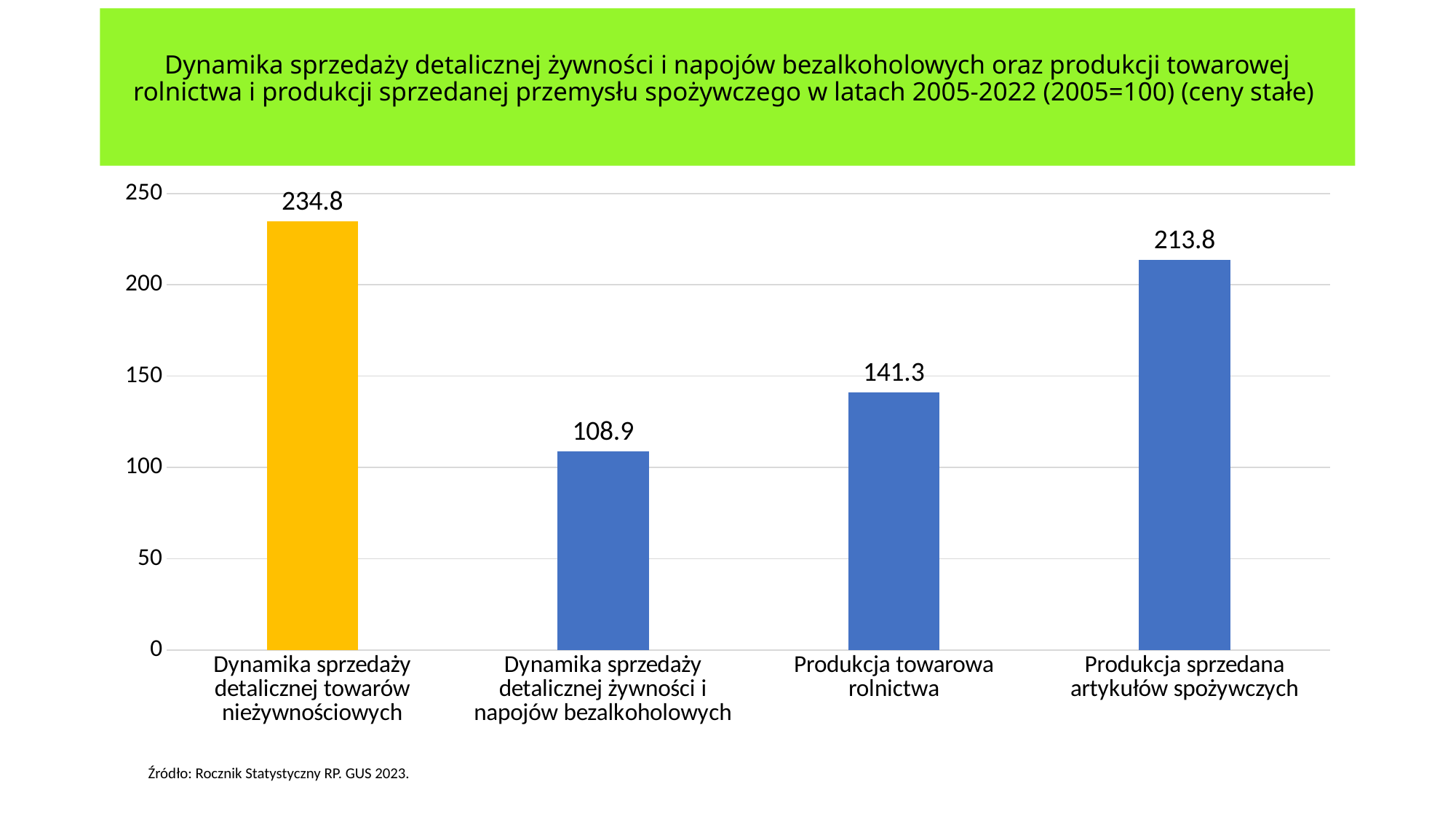
How many categories are shown on the chart? 4 What is the value for "Produkcja sprzedana artykułów spożywczych"? 213.8 Is the value for "Produkcja towarowa rolnictwa" greater or less than 150? less What is the value for "Produkcja towarowa rolnictwa"? 141.3 Which is larger: the value for "Produkcja towarowa rolnictwa" or for "Produkcja sprzedana artykułów spożywczych"? Produkcja sprzedana artykułów spożywczych Which category has the lowest value? Dynamika sprzedaży detalicznej żywności i napojów bezalkoholowych What is the value for "Dynamika sprzedaży detalicznej towarów nieżywnościowych"? 234.8 What is the difference between the values for "Produkcja towarowa rolnictwa" and "Dynamika sprzedaży detalicznej żywności i napojów bezalkoholowych"? 32.4 Which category has the highest value? Dynamika sprzedaży detalicznej towarów nieżywnościowych What is the value for "Dynamika sprzedaży detalicznej żywności i napojów bezalkoholowych"? 108.9 What is the difference between the values for "Dynamika sprzedaży detalicznej towarów nieżywnościowych" and "Produkcja sprzedana artykułów spożywczych"? 21.0 What kind of chart is shown on the slide? bar chart